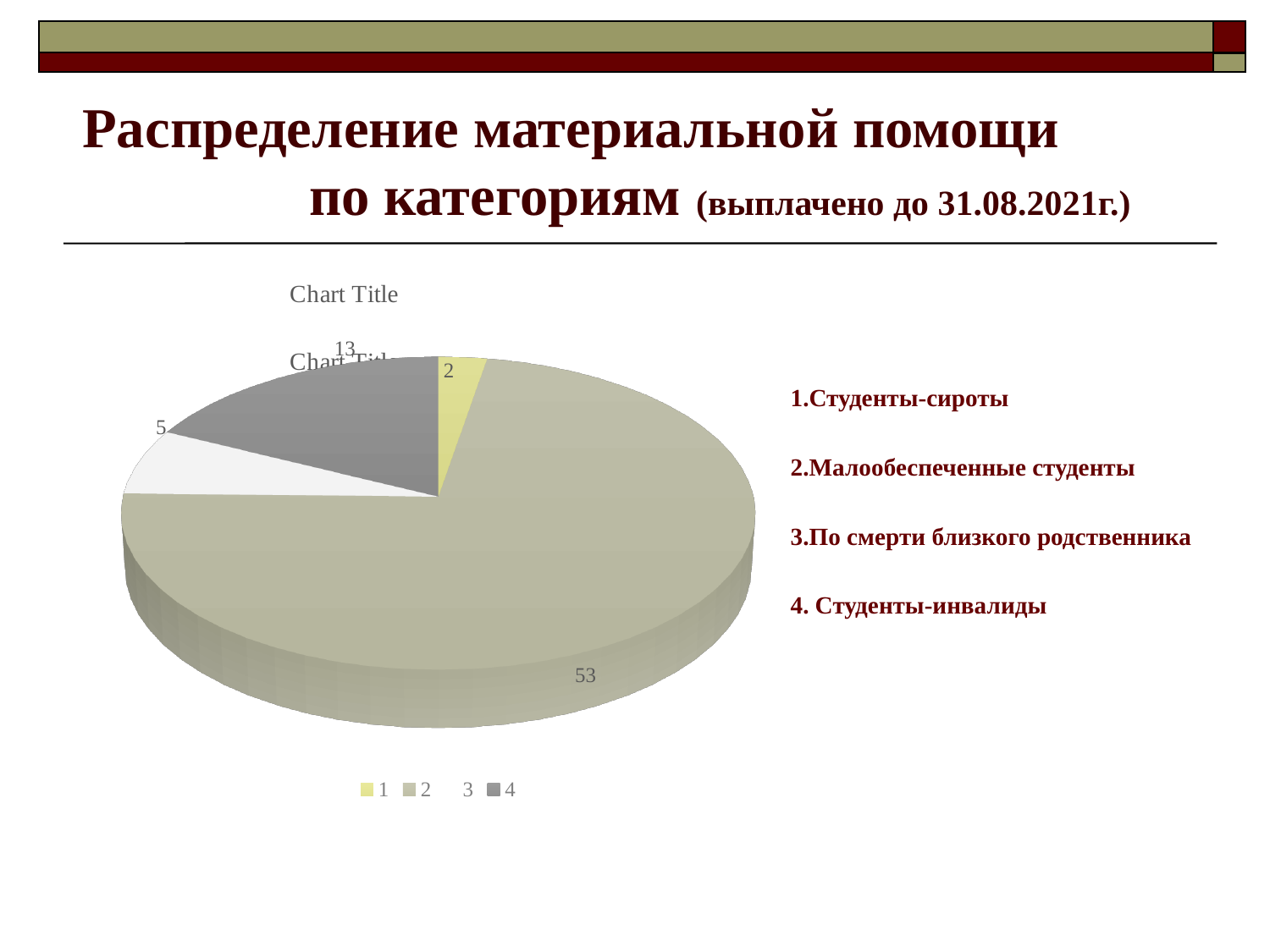
What title is displayed above the pie chart? Chart Title What is the value of slice 1 in the pie chart? 2 What is the total of all the values shown in the pie chart? 73 What is the difference between the values of slice 2 and slice 4? 40 How many slices does the pie chart have? 4 What is the value of slice 4 in the pie chart? 13 What kind of chart is shown on the slide? pie chart Which category has the smallest slice in the pie chart? 1 What is the value of slice 3 in the pie chart? 5 Which is larger, the value of slice 4 or the value of slice 3? 4 Which category has the largest slice in the pie chart? 2 What is the value of slice 2 in the pie chart? 53